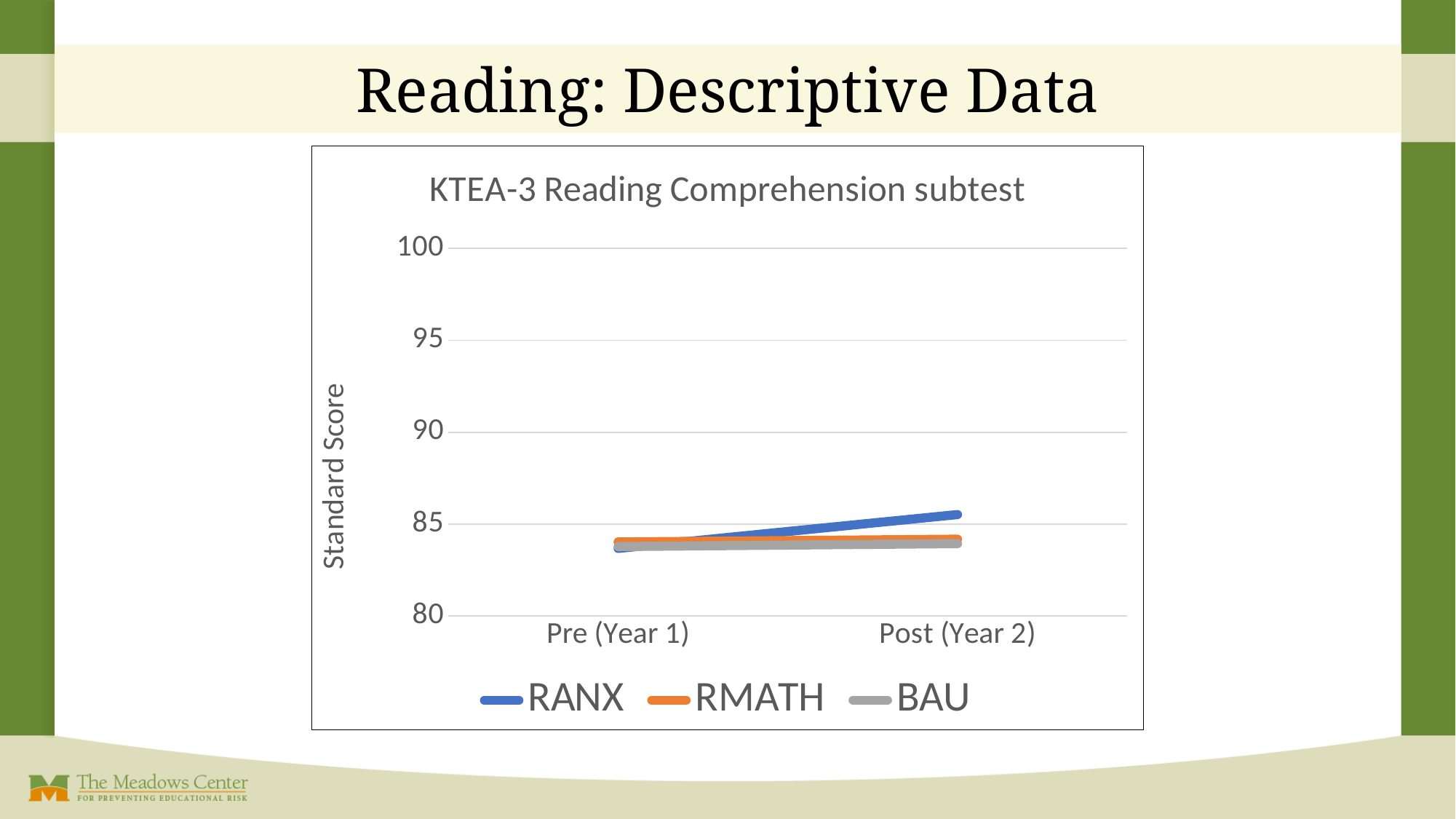
How many time points are shown on the x axis? 2 How many series does the legend list? 3 What is the label on the y axis? Standard Score Does the RANX line rise or fall from Pre (Year 1) to Post (Year 2)? rise Is the value for BAU at Post (Year 2) greater or less than 85? less Is the value for RMATH at Pre (Year 1) greater or less than 90? less What kind of chart is shown on the slide? line chart Is the value for RANX at Post (Year 2) greater or less than 85? greater What is the title of the chart? KTEA-3 Reading Comprehension subtest Which series has the highest value at Post (Year 2)? RANX At Post (Year 2), which is larger: the value for RANX or the value for BAU? RANX